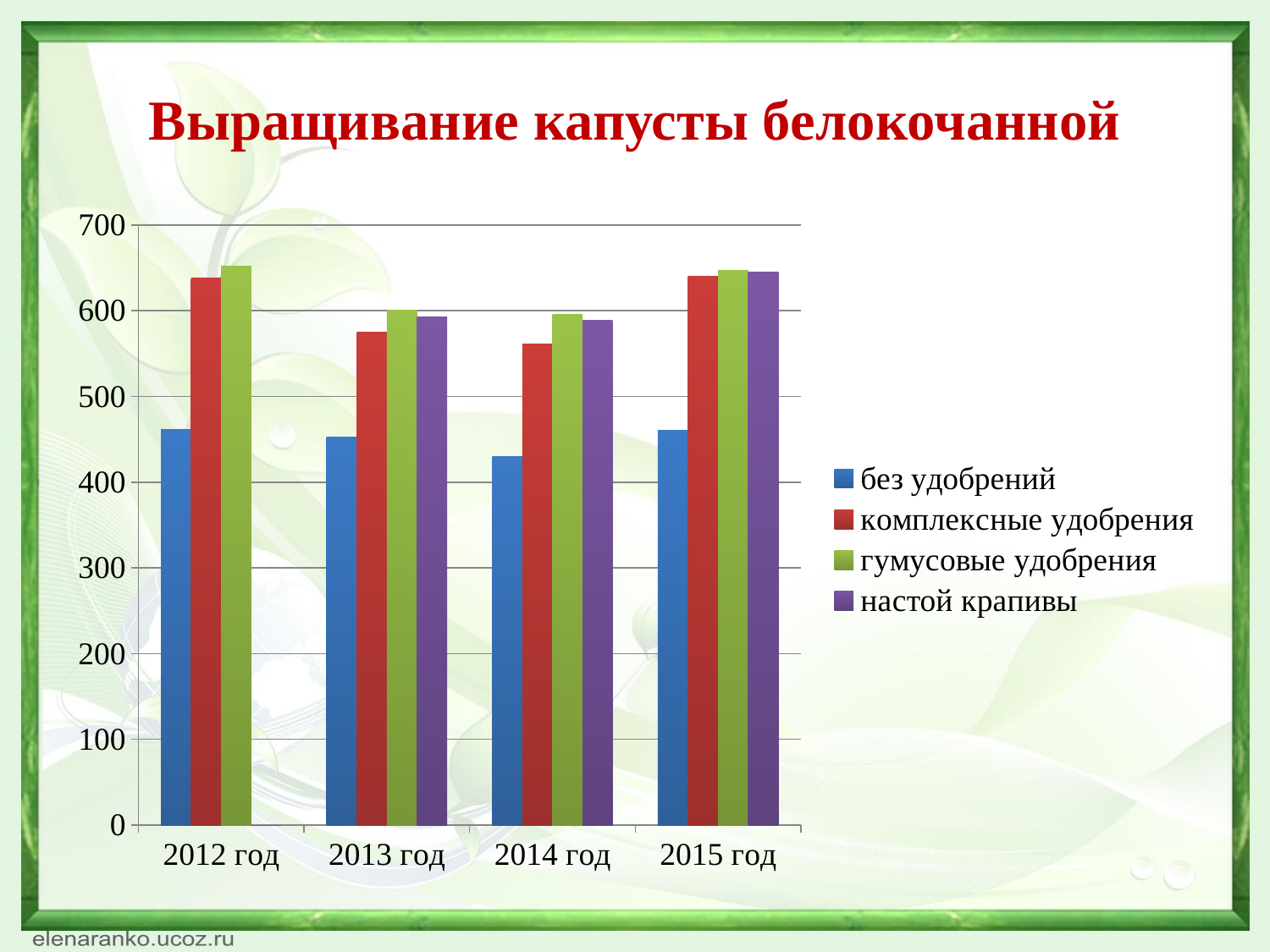
Is the value for без удобрений in 2014 год greater or less than 500? less How many year categories are shown on the x axis? 4 In 2013 год, which series has the lowest value? без удобрений Is the value for гумусовые удобрения in 2012 год greater or less than 600? greater How many series does the legend list? 4 What kind of chart is shown on the slide? bar chart Is the value for настой крапивы in 2014 год greater or less than 500? greater In 2013 год, which is larger: комплексные удобрения or гумусовые удобрения? гумусовые удобрения What colour represents настой крапивы in the legend? purple In which year is the value for без удобрений the lowest? 2014 год What is the title of the slide? Выращивание капусты белокочанной